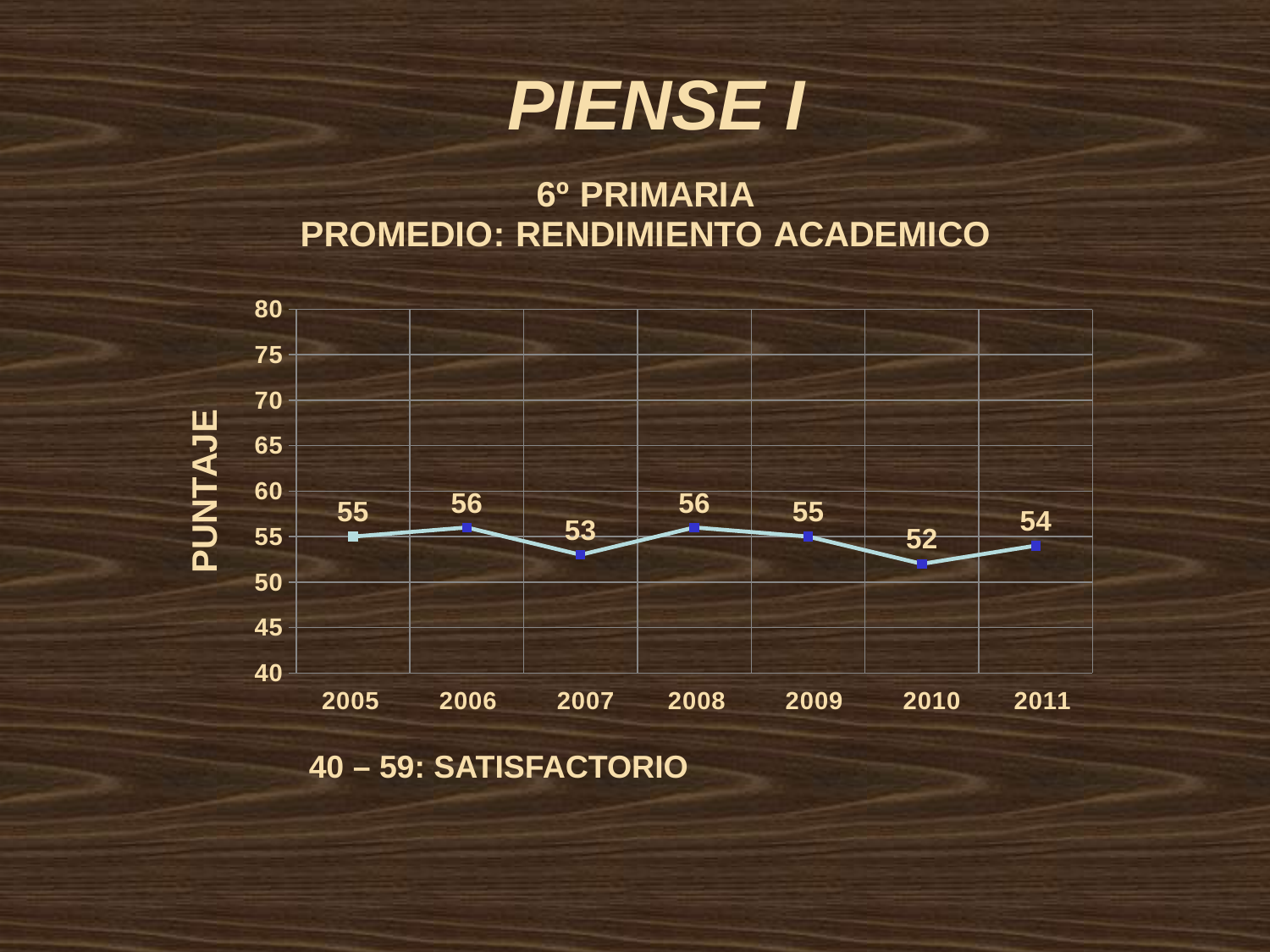
How many years are plotted on the chart? 7 Is the value for 2006 greater or less than 60? less Does the value rise or fall from 2009 to 2010? fall What kind of chart is shown? line chart Which year has the lowest value? 2010 What is the difference between the values for 2008 and 2010? 4 What is the label on the vertical axis? PUNTAJE What is the value for 2010? 52 What is the value for 2005? 55 Which is larger, the value for 2009 or the value for 2011? 2009 What is the value for 2007? 53 What is the value for 2011? 54